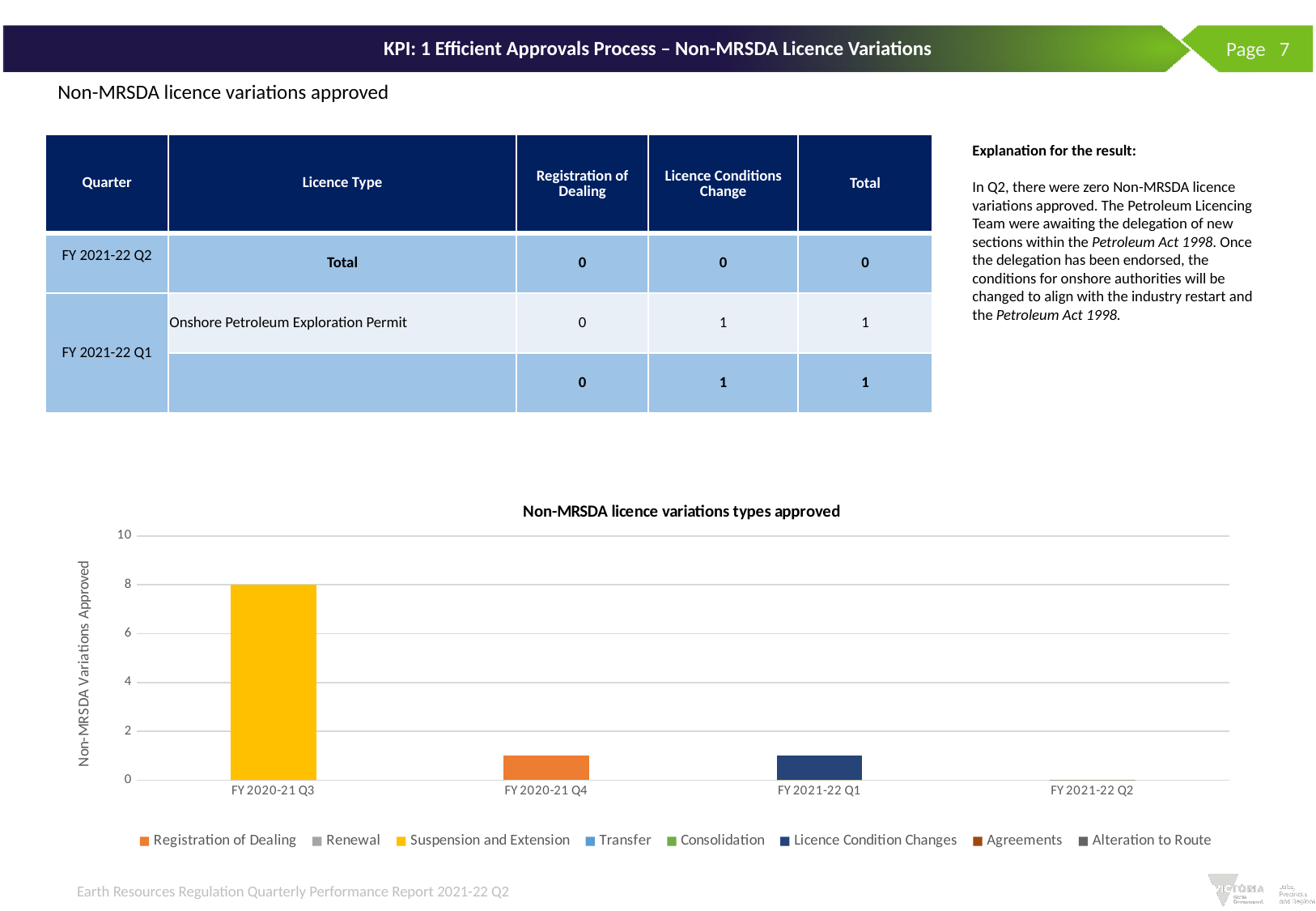
How many series does the legend of the chart "Non-MRSDA licence variations types approved" list? 8 In the chart "Non-MRSDA licence variations types approved", which series does the yellow bar represent? Suspension and Extension In the chart "Non-MRSDA licence variations types approved", is the value for FY 2020-21 Q4 greater or less than 2? less In the chart "Non-MRSDA licence variations types approved", is the value for FY 2020-21 Q3 greater or less than 6? greater How many quarters are shown on the x axis of the chart "Non-MRSDA licence variations types approved"? 4 What type of chart is shown under the title "Non-MRSDA licence variations types approved"? bar chart In the chart "Non-MRSDA licence variations types approved", do the values rise or fall from FY 2020-21 Q3 to FY 2021-22 Q2? fall In the chart "Non-MRSDA licence variations types approved", which quarter has the highest bar? FY 2020-21 Q3 In the chart "Non-MRSDA licence variations types approved", what is the value of the Suspension and Extension bar for FY 2020-21 Q3? 8 In the chart "Non-MRSDA licence variations types approved", which is larger: the bar for FY 2020-21 Q3 or the bar for FY 2021-22 Q1? FY 2020-21 Q3 What is the label on the y axis of the chart "Non-MRSDA licence variations types approved"? Non-MRSDA Variations Approved In the chart "Non-MRSDA licence variations types approved", which quarter has the lowest value? FY 2021-22 Q2